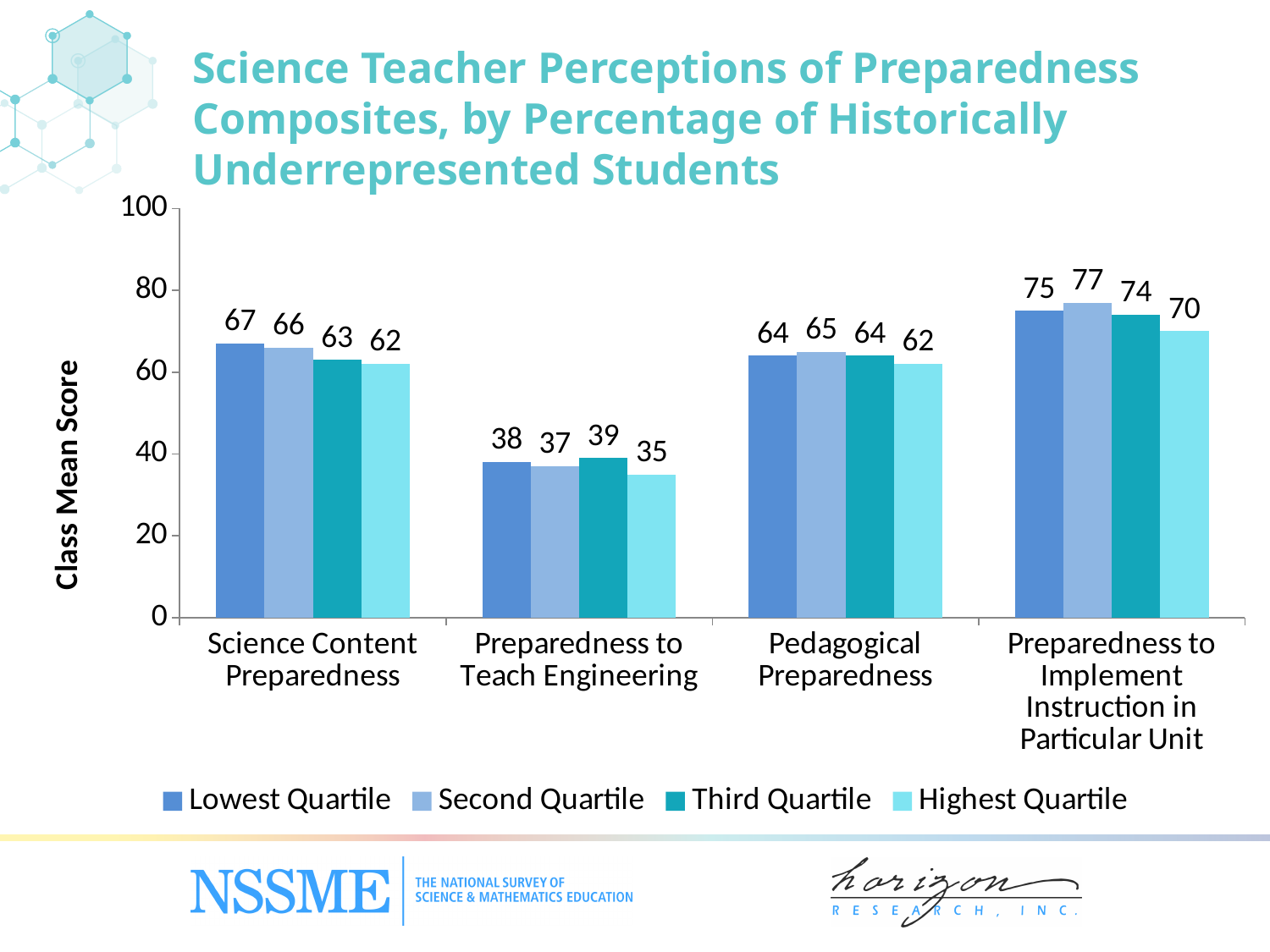
Which category has the lowest Lowest Quartile value? Preparedness to Teach Engineering What is the difference between the Second Quartile and Highest Quartile values for Preparedness to Implement Instruction in Particular Unit? 7 What is the Second Quartile value for Preparedness to Implement Instruction in Particular Unit? 77 What kind of chart is shown on the slide? Bar chart How many series does the legend list? 4 What is the difference between the Lowest Quartile and Highest Quartile values for Science Content Preparedness? 5 How many categories are shown on the x axis? 4 Which category has the highest Highest Quartile value? Preparedness to Implement Instruction in Particular Unit What is the Highest Quartile value for Preparedness to Teach Engineering? 35 What is the Third Quartile value for Pedagogical Preparedness? 64 What is the Lowest Quartile value for Science Content Preparedness? 67 Which is larger for Preparedness to Teach Engineering: the Third Quartile value or the Highest Quartile value? Third Quartile